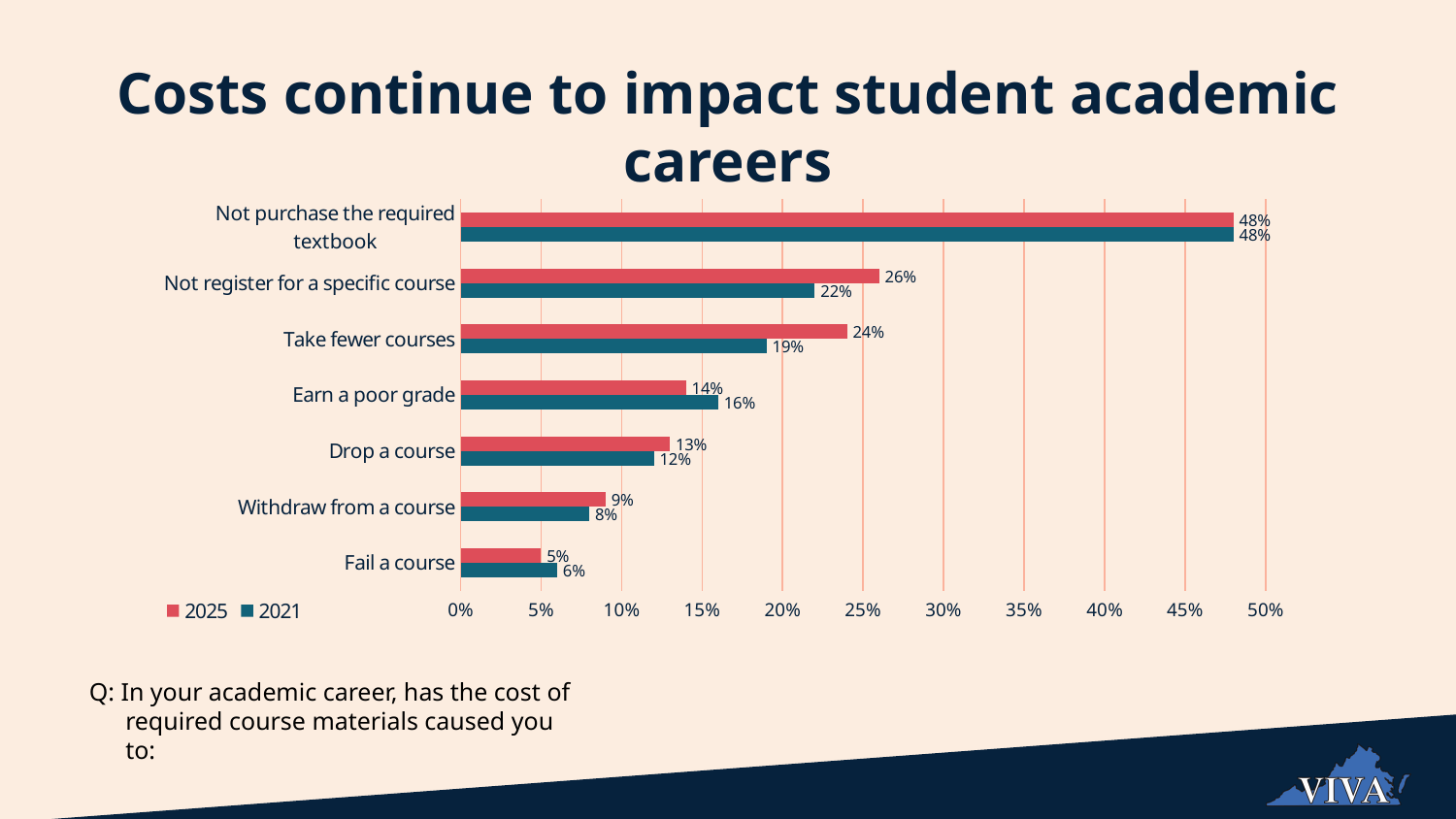
What kind of chart is shown on the slide? Bar chart What is the 2025 value for "Not register for a specific course"? 26% Which category has the highest 2025 value? Not purchase the required textbook For "Earn a poor grade", which year has the larger value, 2025 or 2021? 2021 What is the 2021 value for "Take fewer courses"? 19% Is the 2025 value for "Not register for a specific course" greater or less than 25%? greater Which colour represents the 2021 series? Teal (dark blue-green) What is the 2025 value for "Fail a course"? 5% What is the difference between the 2025 and 2021 values for "Take fewer courses"? 5% Which category has the lowest 2021 value? Fail a course How many categories are shown on the chart? 7 How many series does the legend list? 2